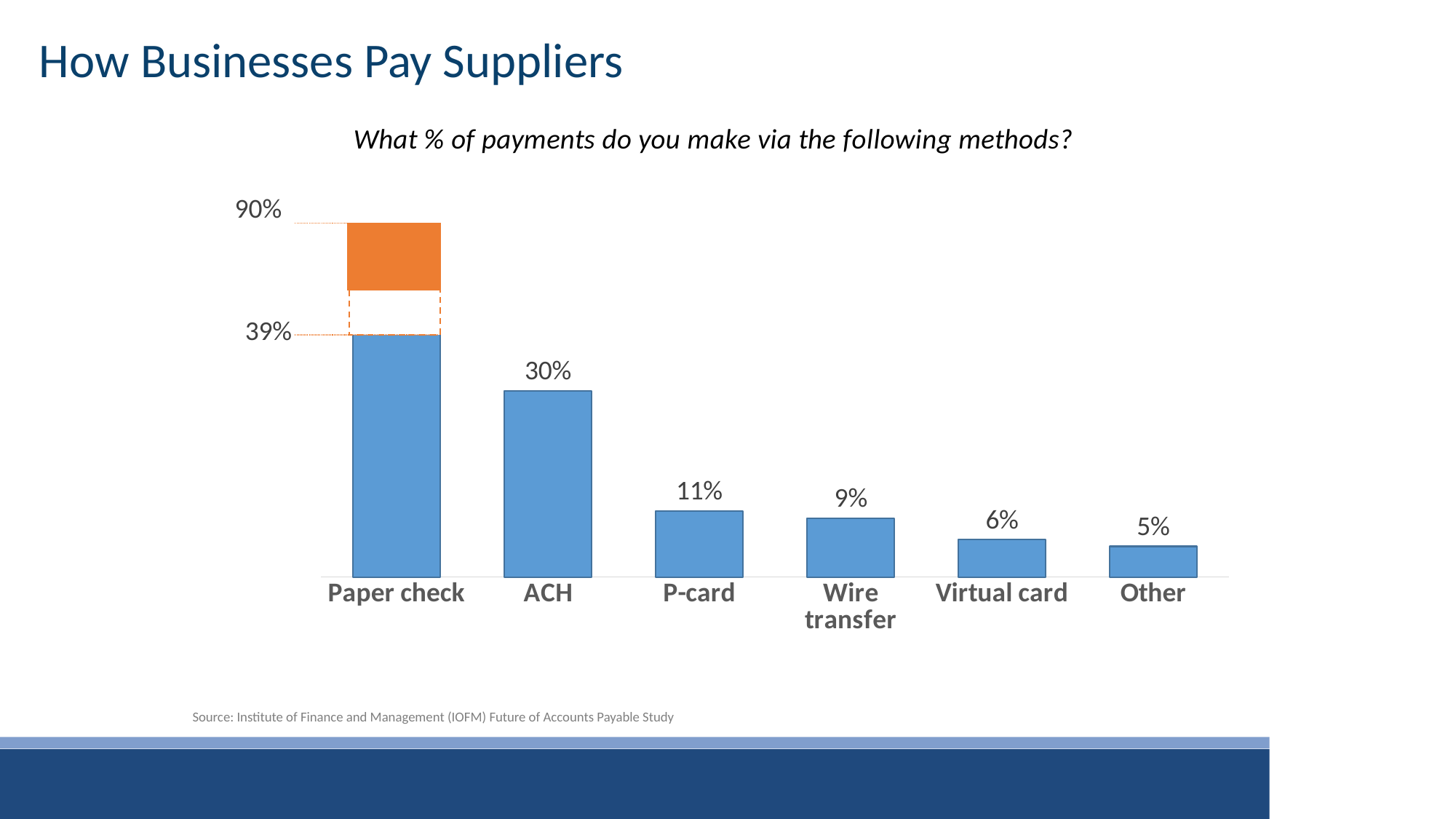
What value is labelled on the blue bar for Paper check? 39% How many payment method categories are shown on the chart? 6 What value is labelled at the top of the orange block above the Paper check bar? 90% What percentage of payments are made via P-card? 11% What percentage of payments are made via wire transfer? 9% What percentage of payments are made via virtual card? 6% Which is larger, the percentage for wire transfer or for virtual card? Wire transfer What kind of chart is shown on the slide? Bar chart Which payment method has the highest percentage among the blue bars? Paper check What percentage of payments are made via ACH? 30% Which payment method has the lowest percentage? Other What is the difference between the ACH percentage and the P-card percentage? 19%